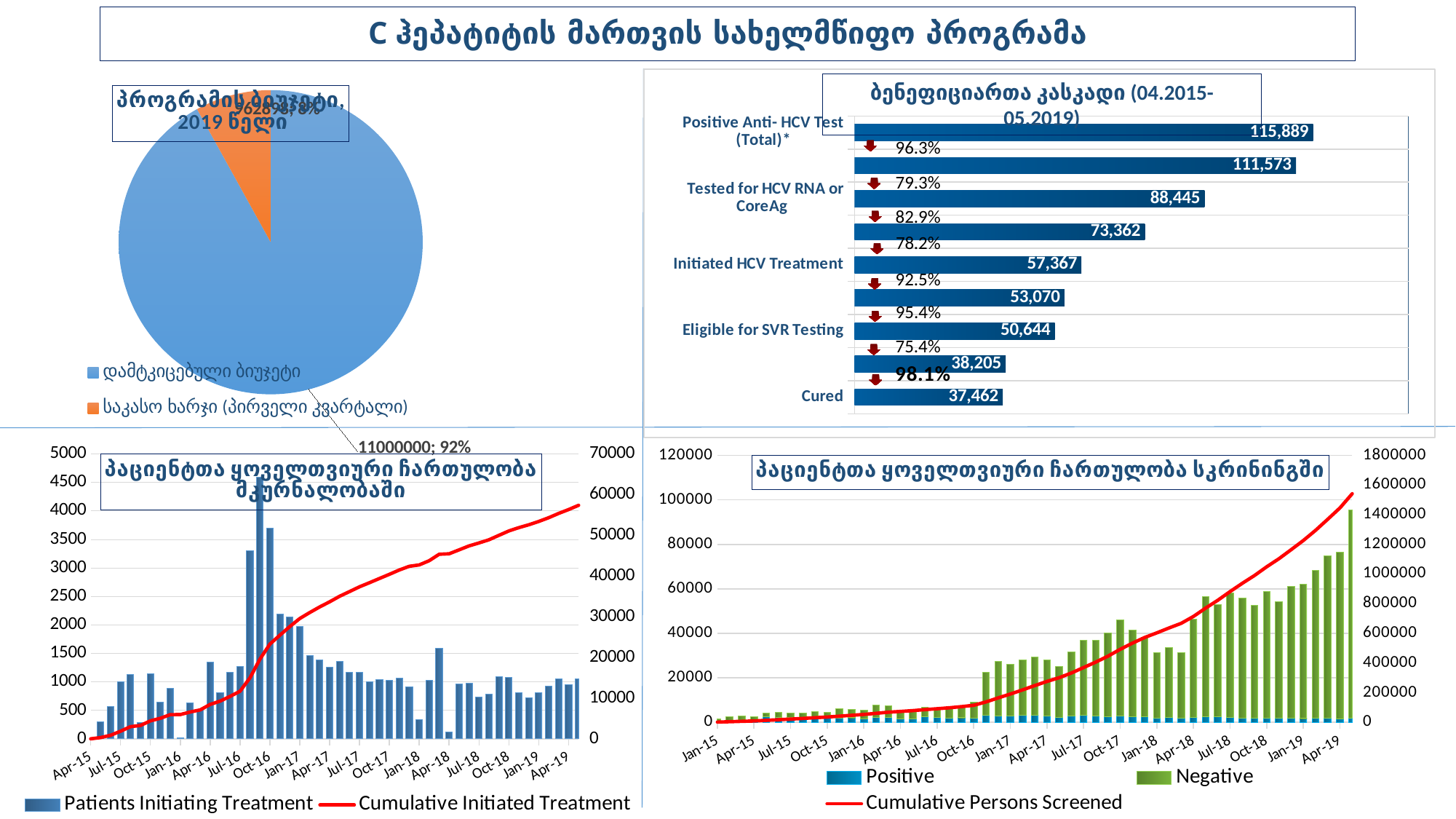
In the cascade chart (ბენეფიციართა კასკადი), what is the value for Initiated HCV Treatment? 57,367 How many series does the legend of the bottom-right chart (პაციენტთა ყოველთვიური ჩართულობა სკრინინგში) list? 3 In the cascade chart (ბენეფიციართა კასკადი), which stage has the highest value? Positive Anti-HCV Test (Total) In the bottom-left chart, does the Cumulative Initiated Treatment line rise or fall from Apr-15 to Apr-19? rises What kind of chart is the top-left chart (პროგრამის ბიუჯეტი, 2019 წელი)? pie chart In the cascade chart (ბენეფიციართა კასკადი), what is the value for Positive Anti-HCV Test (Total)? 115,889 In the cascade chart (ბენეფიციართა კასკადი), which is larger: Initiated HCV Treatment or Eligible for SVR Testing? Initiated HCV Treatment In the cascade chart (ბენეფიციართა კასკადი), what is the value for Eligible for SVR Testing? 50,644 In the cascade chart (ბენეფიციართა კასკადი), what is the value for Cured? 37,462 In the top-left pie chart, what share does the larger (blue) slice represent? 92% In the cascade chart (ბენეფიციართა კასკადი), what is the difference between Positive Anti-HCV Test (Total) and Cured? 78,427